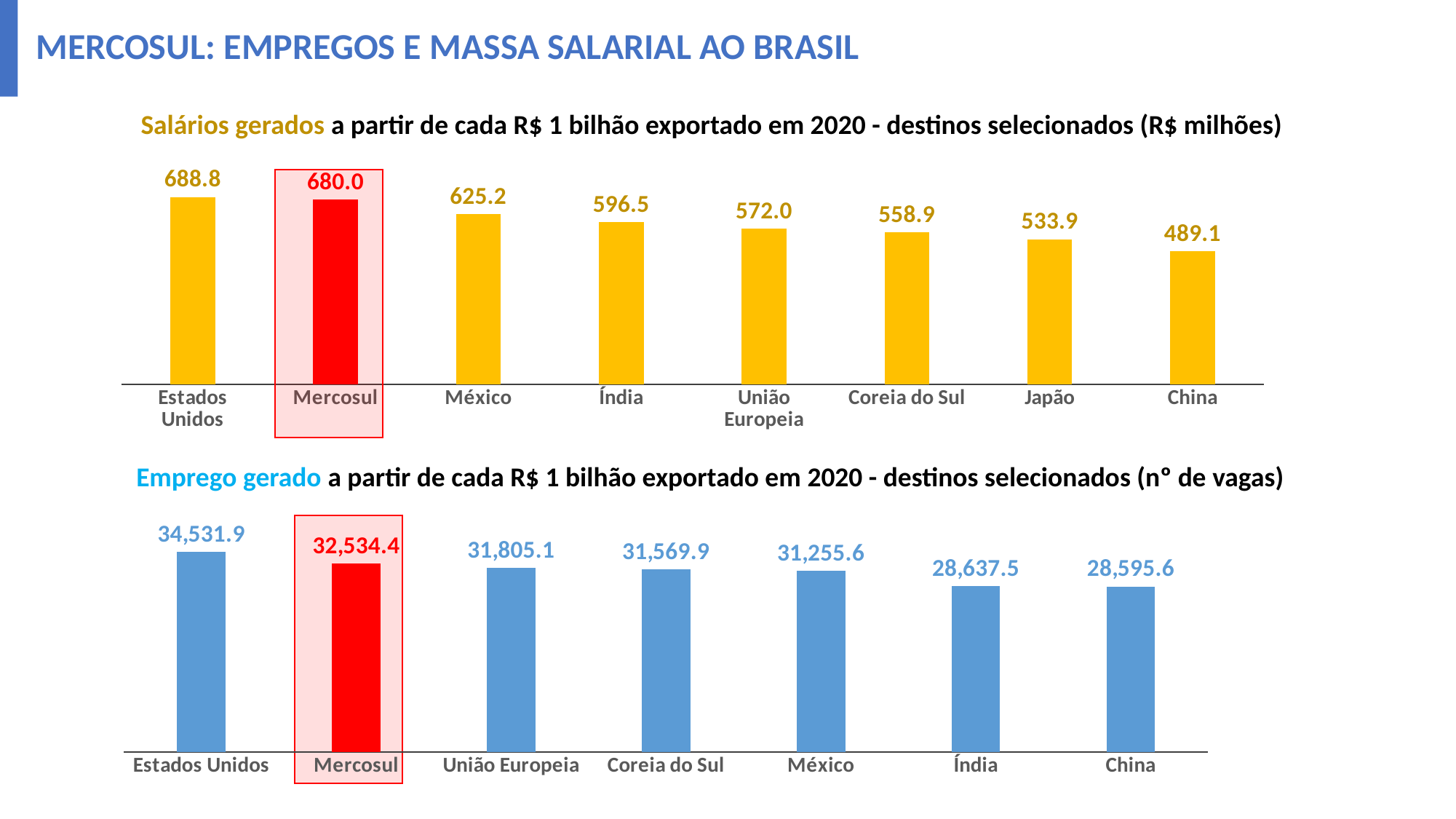
In the top chart (Salários gerados), which destination has the highest value? Estados Unidos In the top chart (Salários gerados), which destination has the lowest value? China In the bottom chart (Emprego gerado), what is the difference between Estados Unidos and Mercosul? 1,997.5 In the bottom chart (Emprego gerado), which destination has the lowest value? China What type of chart is the bottom chart (Emprego gerado)? Bar chart In the bottom chart (Emprego gerado), how many destinations are shown? 7 In the bottom chart (Emprego gerado), which is larger, União Europeia or México? União Europeia In the top chart (Salários gerados), how many destinations are shown? 8 In the top chart (Salários gerados), what is the difference between Estados Unidos and Mercosul? 8.8 In the top chart (Salários gerados), what is the value for Coreia do Sul? 558.9 In the bottom chart (Emprego gerado), what is the value for Mercosul? 32,534.4 In the top chart (Salários gerados), what is the value for Mercosul? 680.0